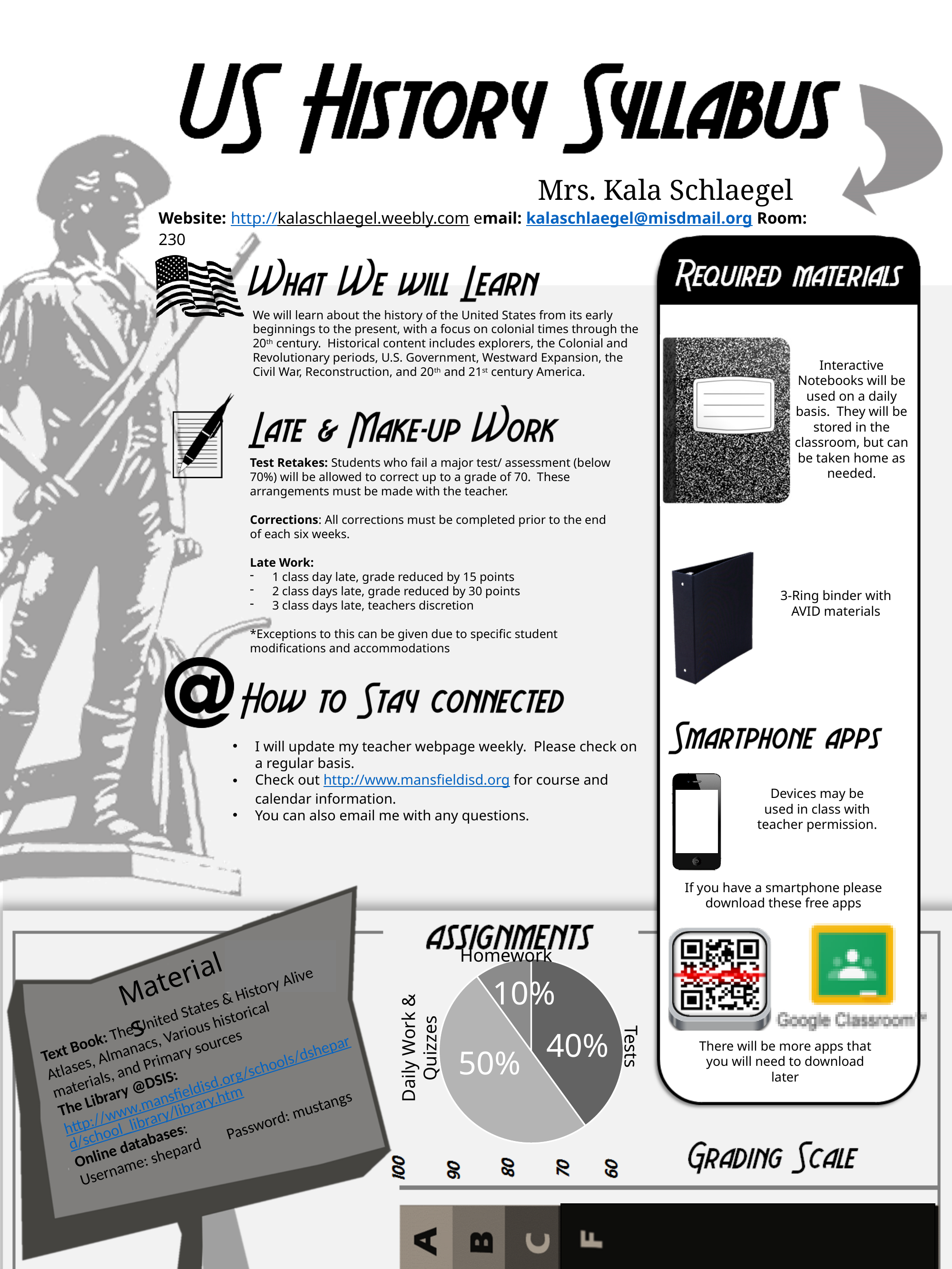
In the Assignments pie chart, what share is Daily Work & Quizzes? 50% In the Assignments pie chart, which is larger: Tests or Homework? Tests Which category has the largest slice in the Assignments pie chart? Daily Work & Quizzes In the Assignments pie chart, what is the difference between the Tests share and the Homework share? 30% In the Assignments pie chart, what is the difference between Daily Work & Quizzes and Tests? 10% How many slices does the Assignments pie chart have? 3 In the Assignments pie chart, which is larger: Daily Work & Quizzes or Tests? Daily Work & Quizzes In the Assignments pie chart, what share is Homework? 10% What kind of chart is shown under the Assignments heading? pie chart What is the heading printed above the pie chart? Assignments In the Assignments pie chart, what share is Tests? 40% Which category has the smallest slice in the Assignments pie chart? Homework